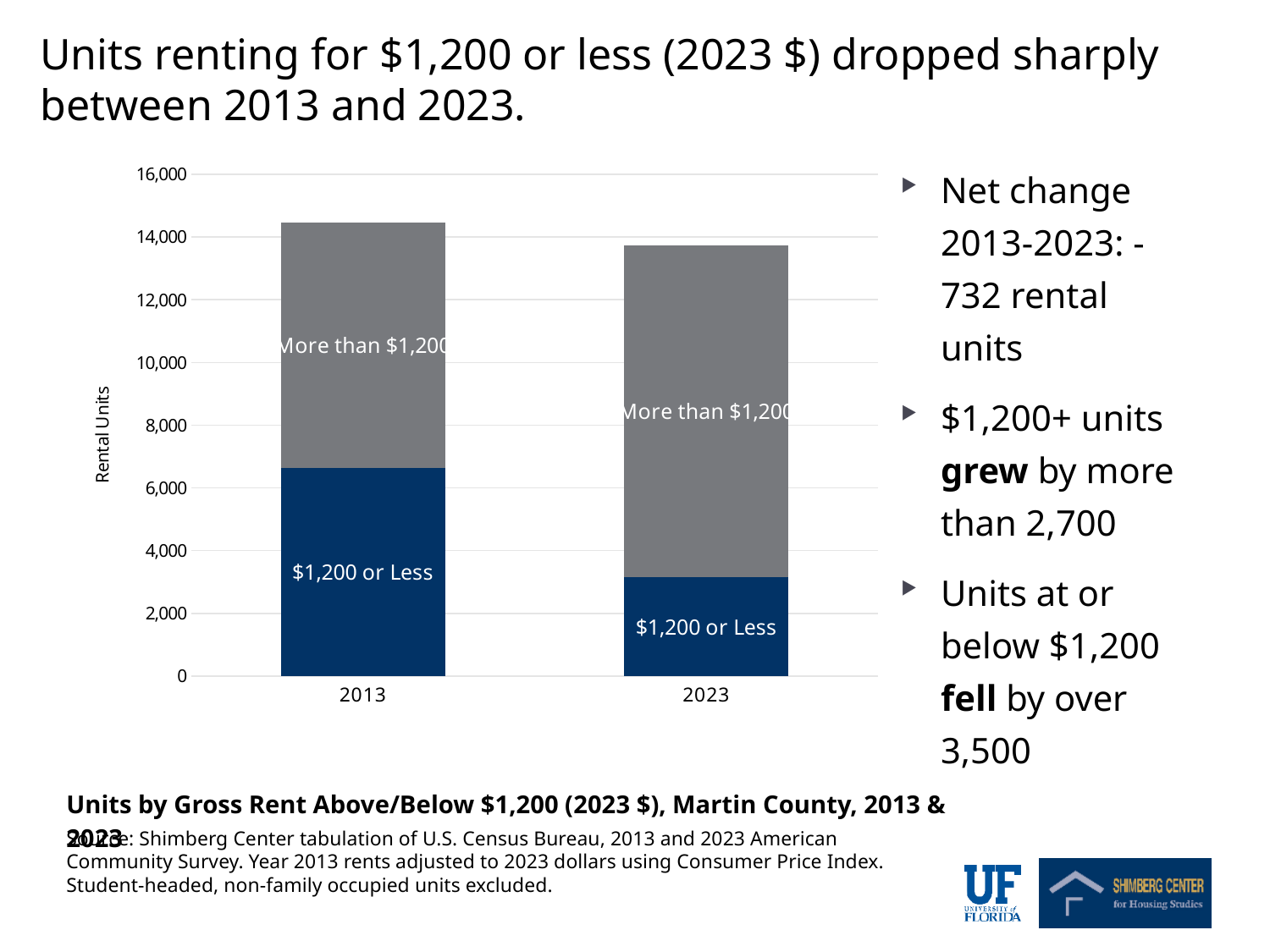
What kind of chart is shown on the slide? stacked bar chart Which year has the larger total number of rental units, 2013 or 2023? 2013 Is the value for "$1,200 or Less" units in 2023 greater or less than 4,000? less How many rent series are stacked in each bar of the chart? 2 Is the total height of the 2013 bar greater or less than 14,000? greater Does the number of "$1,200 or Less" units rise or fall from 2013 to 2023? fall Is the value for "$1,200 or Less" units in 2013 greater or less than 6,000? greater Which year has more "$1,200 or Less" rental units, 2013 or 2023? 2013 Which series is shown in dark blue at the bottom of each bar? $1,200 or Less How many years (categories) are shown on the x axis of the chart? 2 What is the label on the vertical axis of the chart? Rental Units